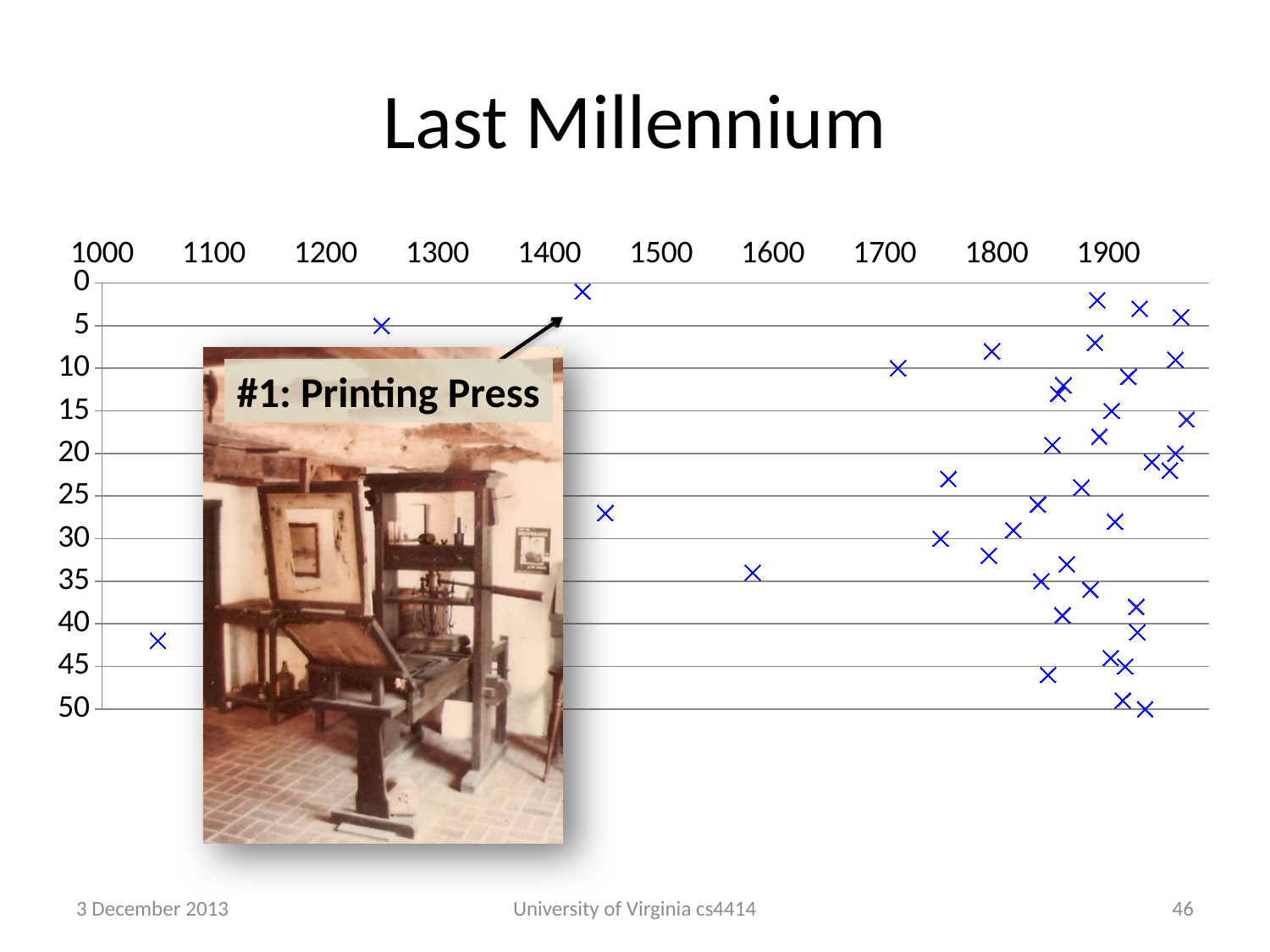
Is the y value of the point labelled "#1: Printing Press" greater or less than 5? less What kind of chart is shown on the slide? scatter chart Is the x value of the point plotted near the year 1600 greater or less than 1500? greater Is the y value of the point plotted near the year 1450 (just right of the photo) greater or less than 20? greater What are the first and last tick labels on the x axis of the chart? 1000 and 1900 What text does the annotation box on the chart show? #1: Printing Press